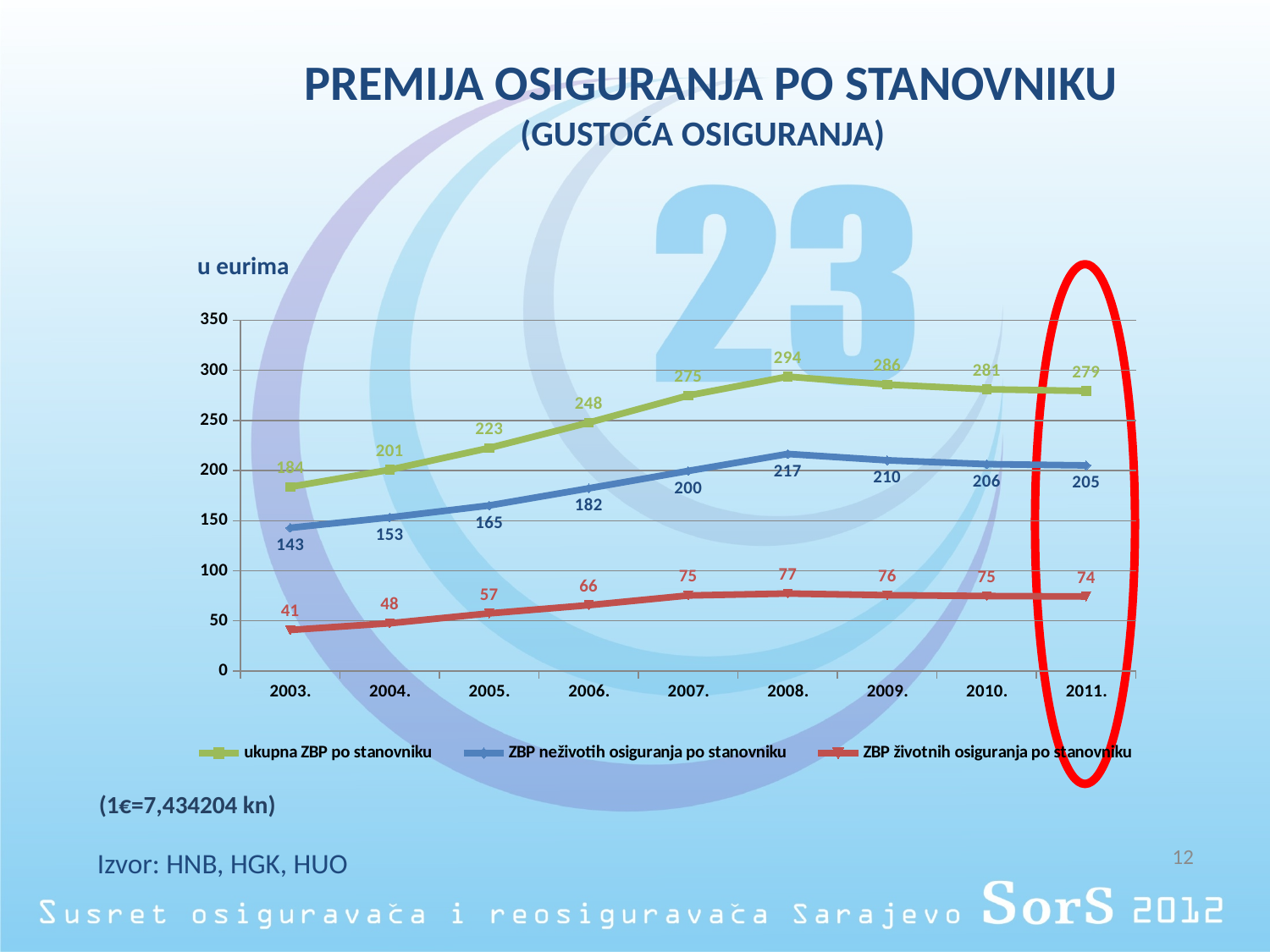
What is the difference between ukupna ZBP po stanovniku and ZBP neživotih osiguranja po stanovniku in 2011.? 74 What type of chart is shown on the slide? line chart How many series does the legend list? 3 What is the value of ZBP neživotih osiguranja po stanovniku in 2003.? 143 What is the value of ukupna ZBP po stanovniku in 2008.? 294 What is the value of ZBP životnih osiguranja po stanovniku in 2011.? 74 Does ukupna ZBP po stanovniku rise or fall from 2003. to 2008.? rise In which year is ZBP životnih osiguranja po stanovniku lowest? 2003. Which is larger in 2007.: ZBP neživotih osiguranja po stanovniku or ZBP životnih osiguranja po stanovniku? ZBP neživotih osiguranja po stanovniku What unit is stated above the chart? u eurima How many years are shown on the x axis? 9 In which year is ukupna ZBP po stanovniku highest? 2008.